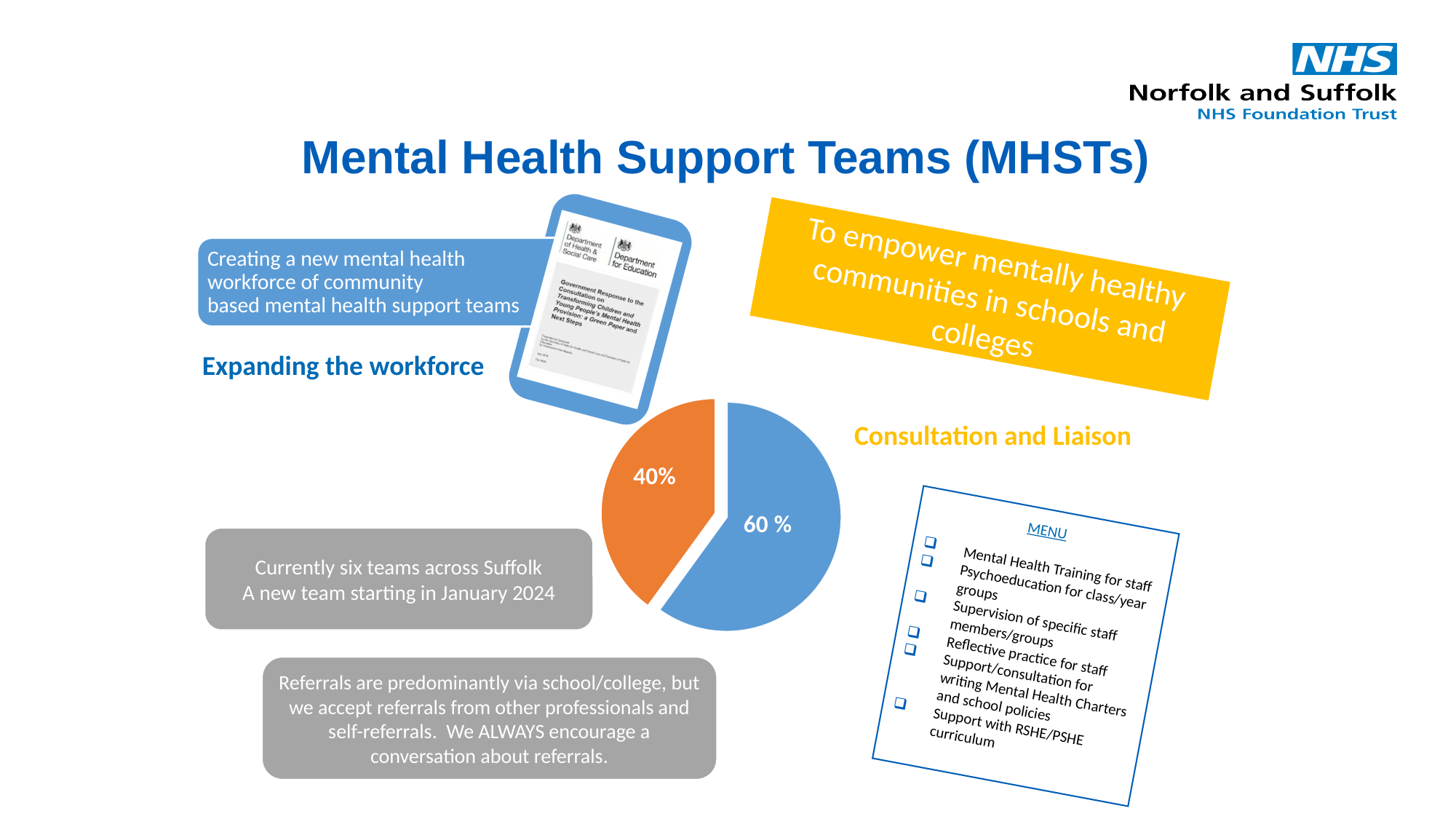
What value is labelled on the blue slice of the pie chart? 60 % What value is labelled on the orange slice of the pie chart? 40% What colour is the larger slice of the pie chart? blue Does the pie chart have a legend? No What kind of chart is shown on the slide? pie chart Which slice of the pie chart is the largest? the blue slice (60 %) Which is larger in the pie chart, the blue slice or the orange slice? the blue slice What is the difference between the blue slice and the orange slice in the pie chart? 20 percentage points What share of the pie does the orange slice represent? 40% How many slices does the pie chart have? 2 Is the blue slice of the pie chart greater or less than 50%? greater Which slice of the pie chart is the smallest? the orange slice (40%)